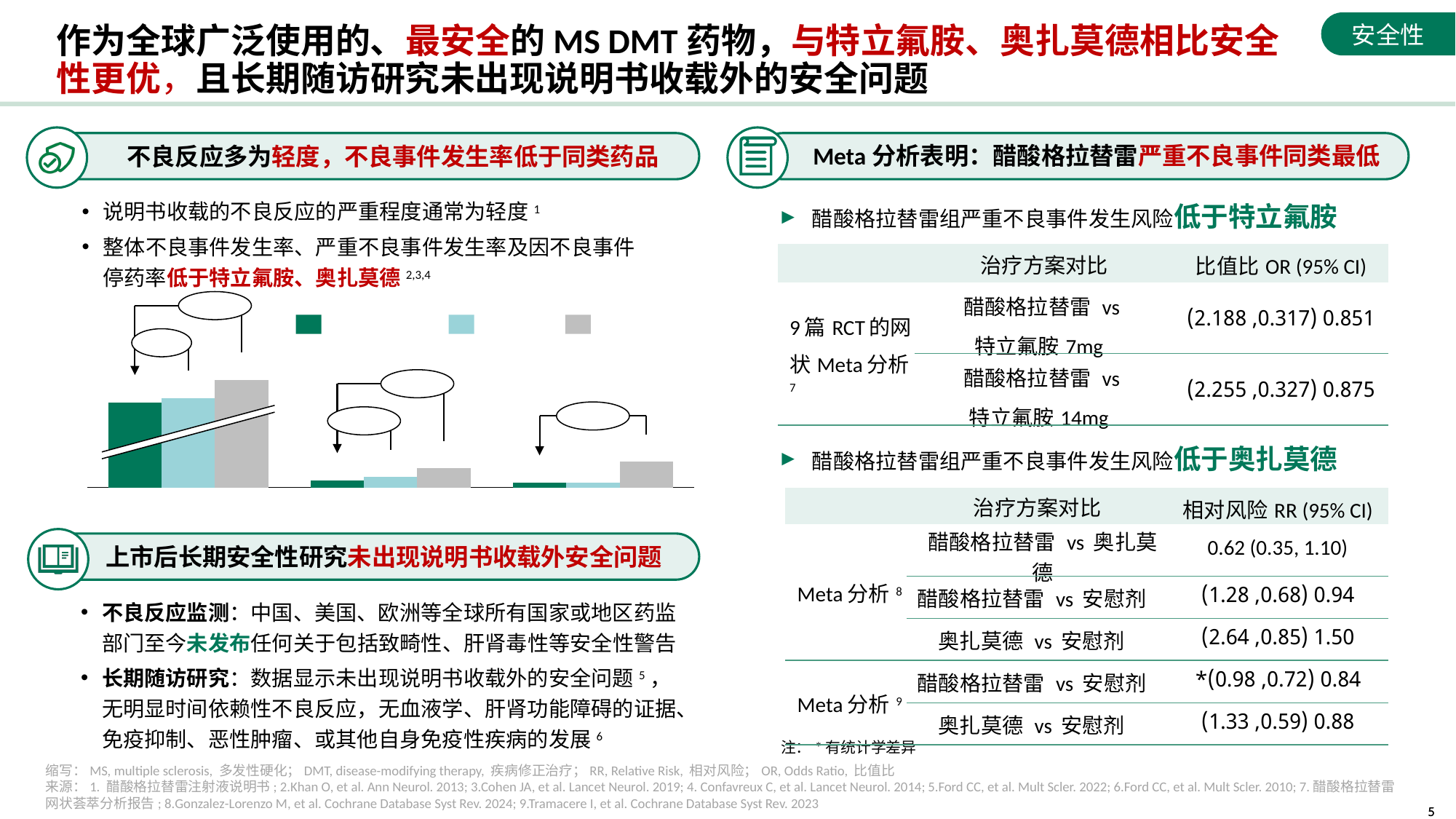
In the middle group of bars, is the gray bar taller or shorter than the dark green bar? taller How many colour entries does the legend of the bar chart show? 3 Do the dark green bars rise or fall from the leftmost group to the rightmost group? fall In the leftmost group of bars, which colour bar is the tallest? gray Does the bar chart show any numeric axis tick labels? no What colour is the first (leftmost) legend swatch of the bar chart? dark green Do the gray bars rise or fall from the leftmost group to the rightmost group? fall In the middle group of bars, which colour bar is the shortest? dark green In the rightmost group of bars, which colour bar is the tallest? gray Which group of bars in the chart has the tallest bars overall? the leftmost group What kind of chart is shown on the left side of the slide? bar chart How many groups of bars are plotted in the bar chart? 3